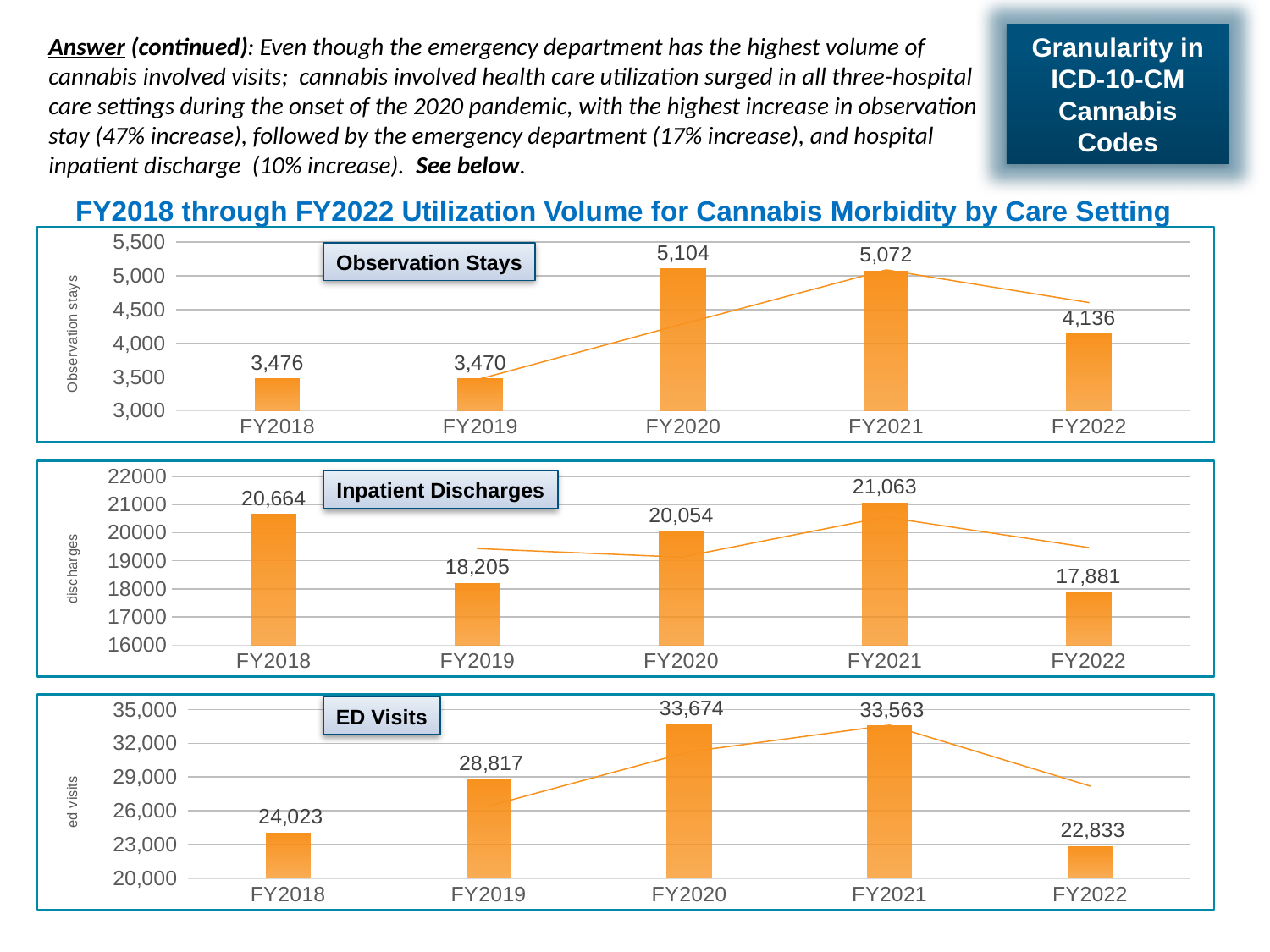
In the Observation Stays chart, what is the value for FY2020? 5,104 In the ED Visits chart, which fiscal year has the lowest value? FY2022 In the Inpatient Discharges chart, what is the value for FY2019? 18,205 In the ED Visits chart, do the values rise or fall from FY2018 to FY2020? rise In the Observation Stays chart, is the value for FY2022 greater or less than 4,000? greater In the ED Visits chart, what is the difference between the FY2020 value and the FY2018 value? 9,651 In the Inpatient Discharges chart, which is larger, the value for FY2018 or the value for FY2020? FY2018 In the ED Visits chart, what is the value for FY2022? 22,833 What kind of chart is the Inpatient Discharges chart? bar chart In the Inpatient Discharges chart, which fiscal year has the highest value? FY2021 How many fiscal years are shown on the x axis of the ED Visits chart? 5 In the Observation Stays chart, what is the difference between the FY2020 value and the FY2019 value? 1,634